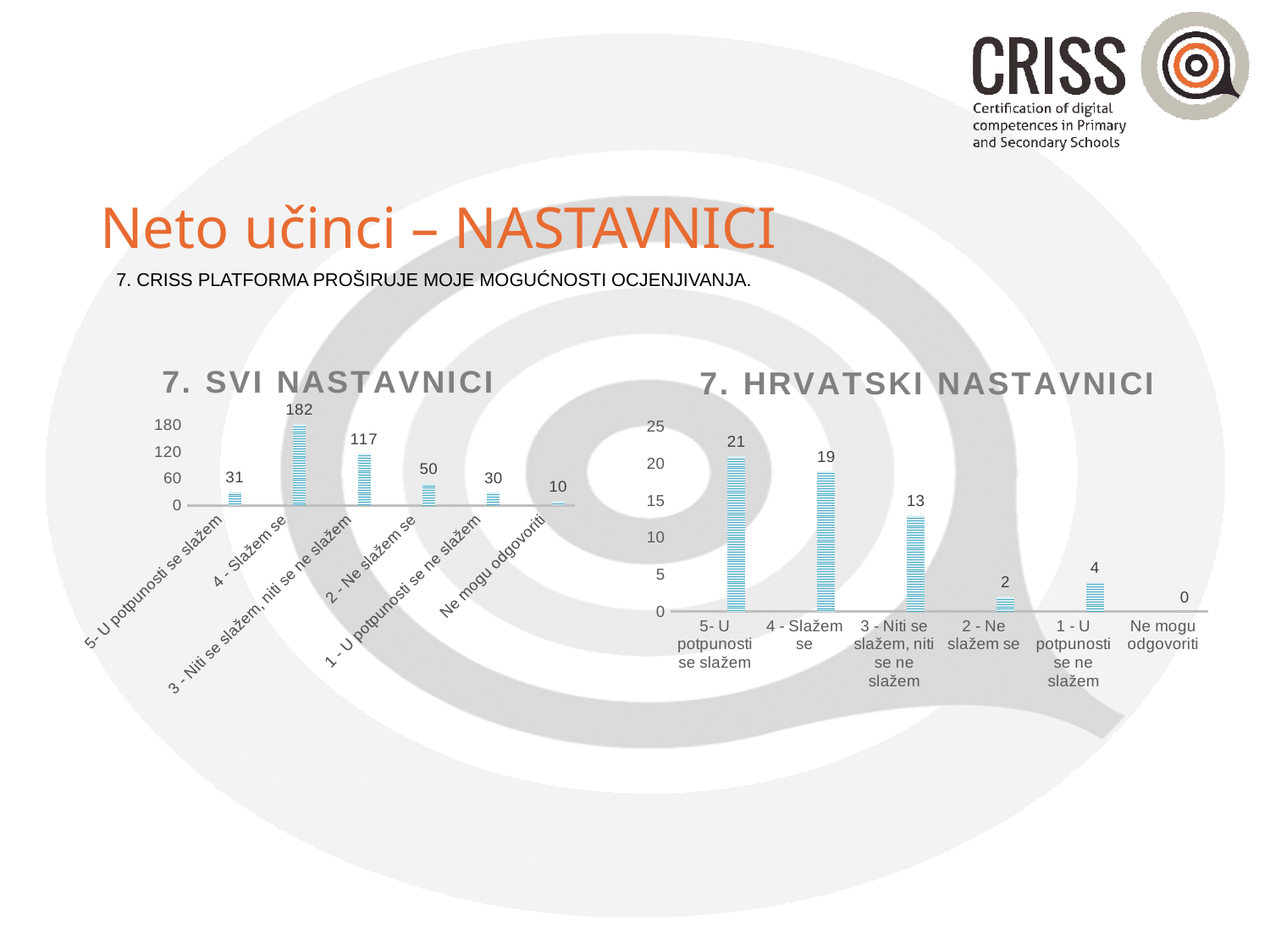
In the '7. SVI NASTAVNICI' chart, what is the value for '4 - Slažem se'? 182 In the '7. HRVATSKI NASTAVNICI' chart, what is the value for '1 - U potpunosti se ne slažem'? 4 In the '7. SVI NASTAVNICI' chart, which category has the highest value? 4 - Slažem se In the '7. HRVATSKI NASTAVNICI' chart, what is the difference between '5- U potpunosti se slažem' and '2 - Ne slažem se'? 19 In the '7. HRVATSKI NASTAVNICI' chart, which category has the lowest value? Ne mogu odgovoriti In the '7. HRVATSKI NASTAVNICI' chart, what is the value for '5- U potpunosti se slažem'? 21 In the '7. HRVATSKI NASTAVNICI' chart, which is larger: '4 - Slažem se' or '3 - Niti se slažem, niti se ne slažem'? 4 - Slažem se What type of chart is the '7. HRVATSKI NASTAVNICI' chart? Bar chart In the '7. SVI NASTAVNICI' chart, is the value for '5- U potpunosti se slažem' greater or less than 60? less In the '7. SVI NASTAVNICI' chart, what is the value for 'Ne mogu odgovoriti'? 10 In the '7. SVI NASTAVNICI' chart, what is the difference between '4 - Slažem se' and '3 - Niti se slažem, niti se ne slažem'? 65 In the '7. SVI NASTAVNICI' chart, how many categories are shown? 6